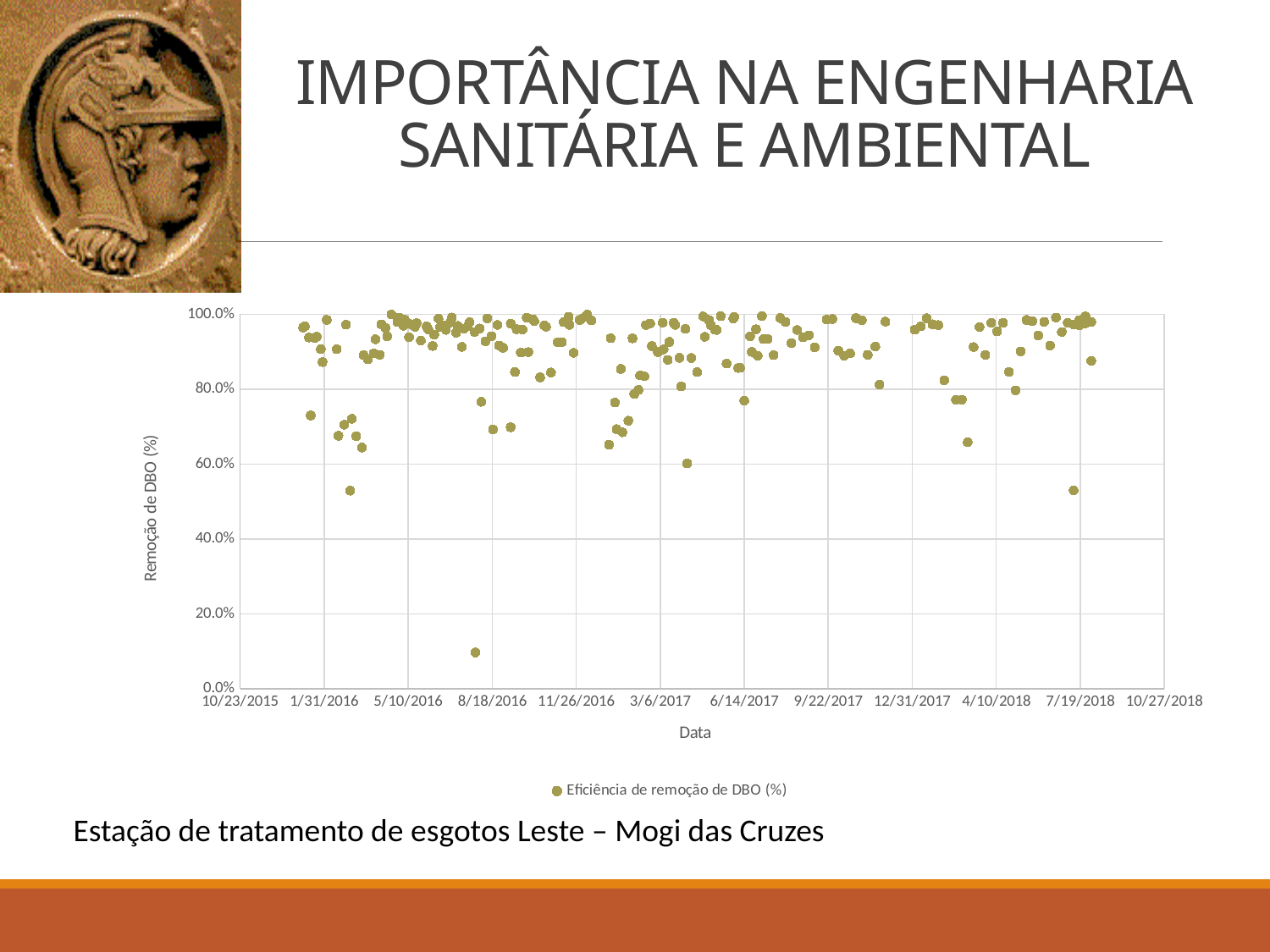
Is the lowest plotted value near 7/19/2018 greater or less than 60.0%? less What is the legend entry of the series plotted in the chart? Eficiência de remoção de DBO (%) What is the title of the vertical axis of the chart? Remoção de DBO (%) Is the lowest plotted value in the chart (near 8/18/2016) greater or less than 20.0%? less How many series does the legend of the chart list? 1 What kind of chart is shown on the slide? Scatter chart Is the lowest plotted value near 3/6/2017 greater or less than 40.0%? greater